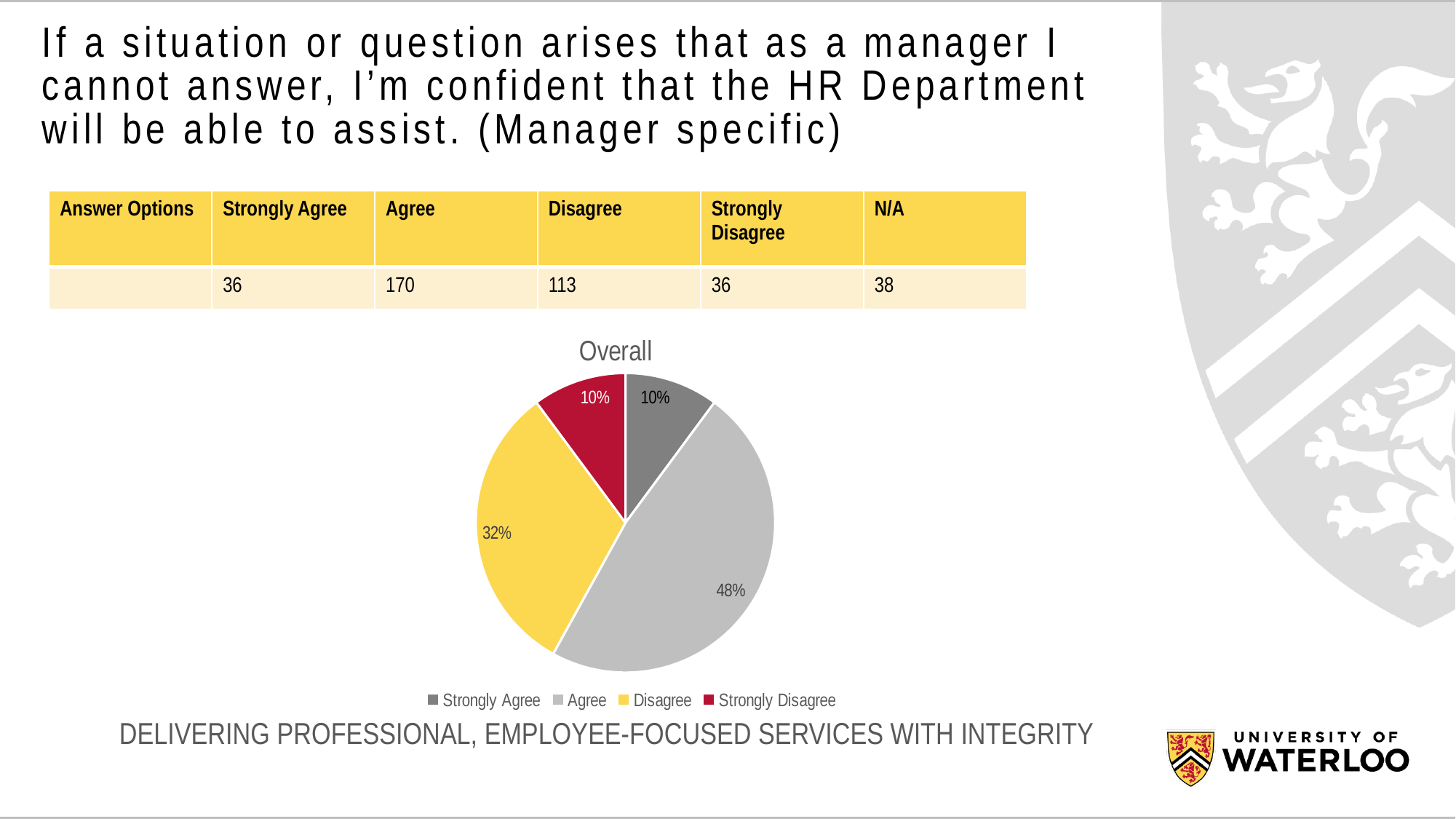
What is the title of the pie chart? Overall What share of the pie does Strongly Agree represent? 10% What share of the pie does Strongly Disagree represent? 10% What share of the pie does Agree represent? 48% Which category has the largest slice of the pie? Agree What type of chart is shown on the slide? Pie chart What colour is the Strongly Disagree slice in the pie chart? Red How many slices does the pie chart have? 4 Which slice is larger, Disagree or Strongly Disagree? Disagree How many entries does the legend of the pie chart list? 4 What is the difference in percentage points between the Agree slice and the Disagree slice? 16